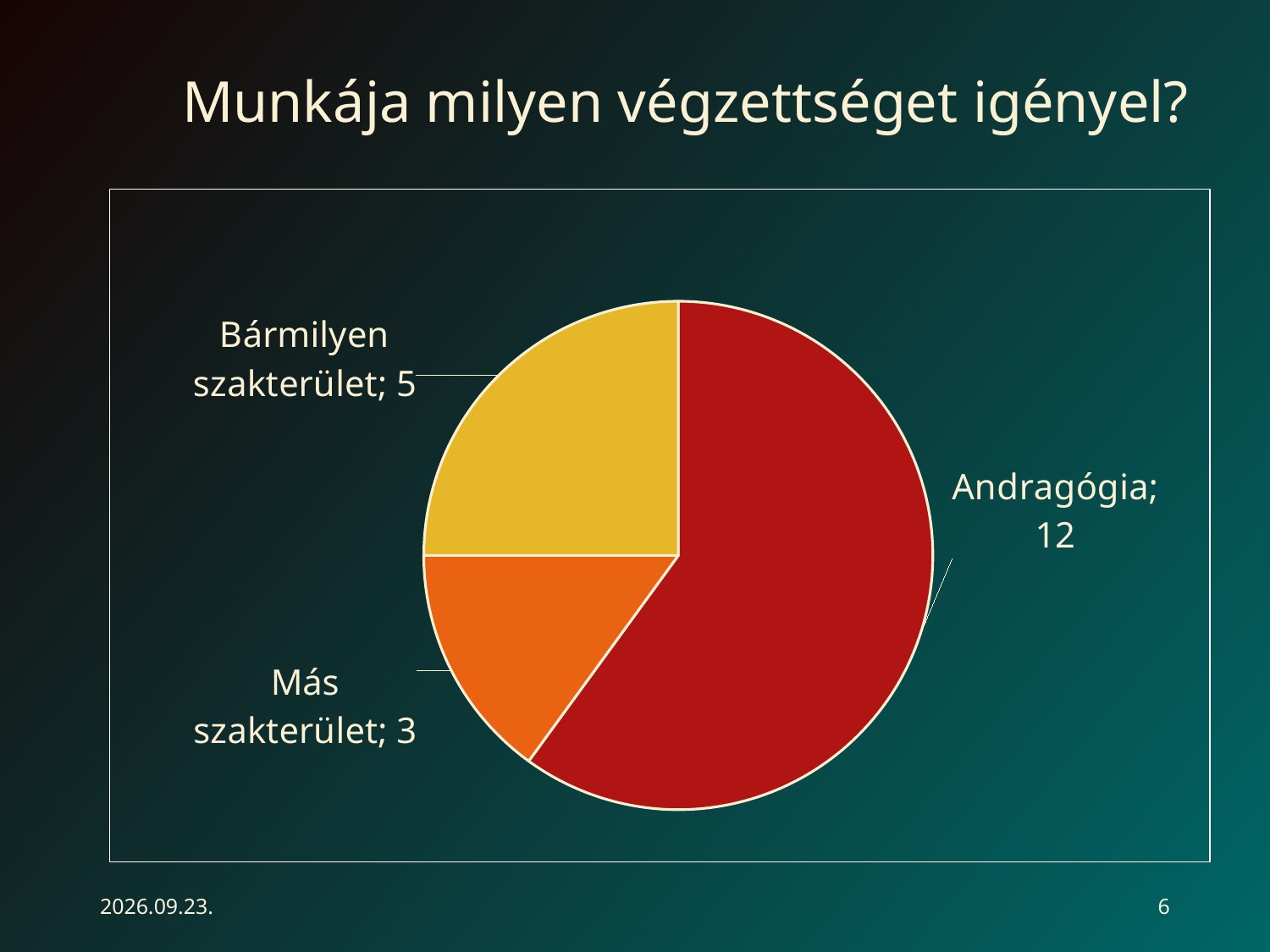
What is the value for Más szakterület? 3 What is the value for Bármilyen szakterület? 5 What is the title of the slide? Munkája milyen végzettséget igényel? What is the value for Andragógia? 12 Which category has the smallest slice? Más szakterület What share of the pie does Andragógia represent? 60% How many categories does the pie chart have? 3 What is the difference between the values for Andragógia and Bármilyen szakterület? 7 Which category has the largest slice? Andragógia What type of chart is shown on the slide? pie chart What is the difference between the values for Bármilyen szakterület and Más szakterület? 2 Which is larger, the value for Bármilyen szakterület or the value for Más szakterület? Bármilyen szakterület